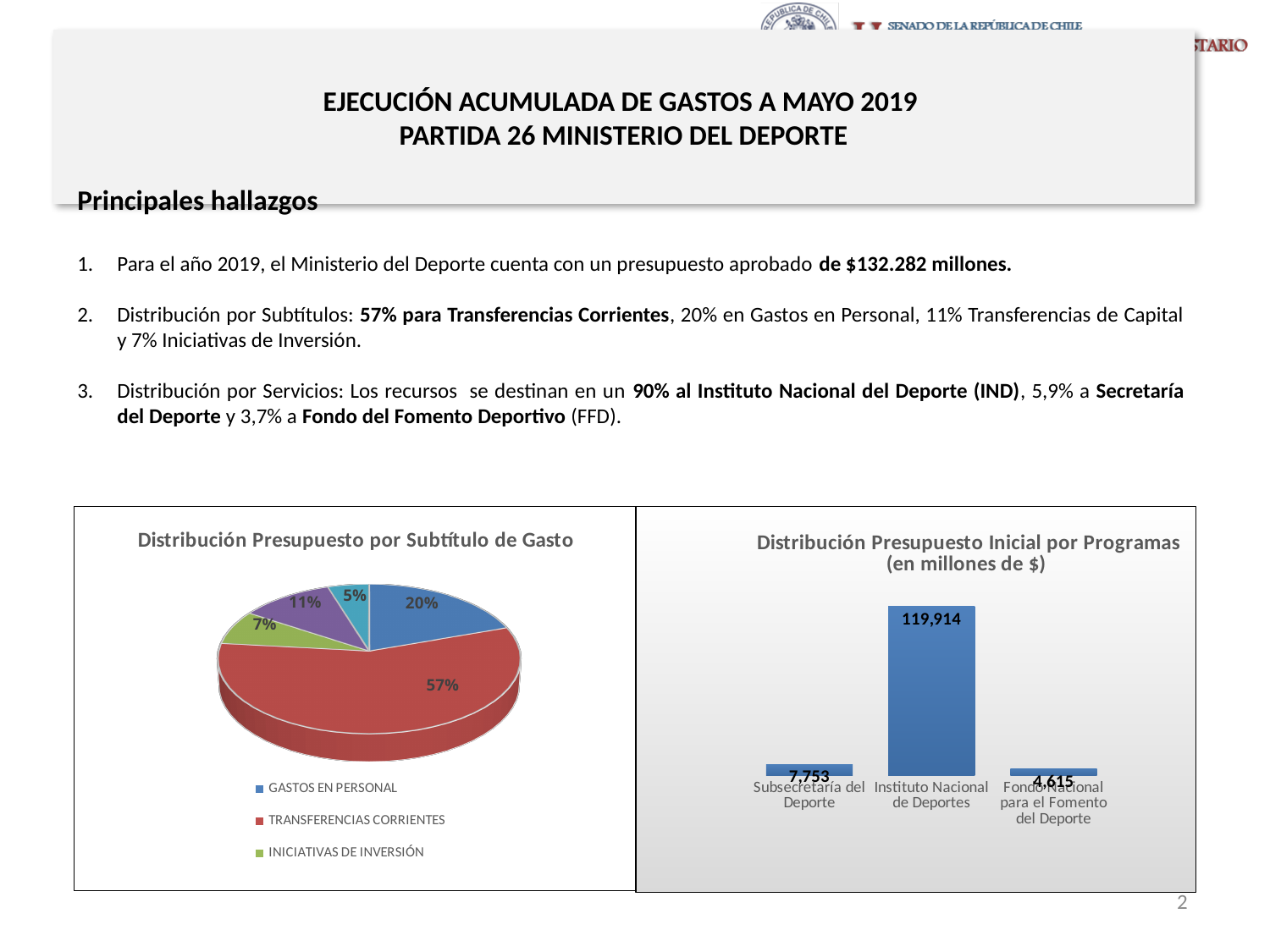
In the chart 'Distribución Presupuesto Inicial por Programas', which program has the lowest value? Fondo Nacional para el Fomento del Deporte What kind of chart is 'Distribución Presupuesto por Subtítulo de Gasto'? Pie chart In the pie chart 'Distribución Presupuesto por Subtítulo de Gasto', what share is shown for Iniciativas de Inversión? 7% In the chart 'Distribución Presupuesto Inicial por Programas', what is the difference between the values for Subsecretaría del Deporte and Fondo Nacional para el Fomento del Deporte? 3,138 How many entries does the legend of the pie chart 'Distribución Presupuesto por Subtítulo de Gasto' list? 3 In the pie chart 'Distribución Presupuesto por Subtítulo de Gasto', what share is shown for Transferencias Corrientes? 57% What kind of chart is 'Distribución Presupuesto Inicial por Programas'? Bar chart In the pie chart 'Distribución Presupuesto por Subtítulo de Gasto', which legend category has the largest slice? Transferencias Corrientes In the pie chart 'Distribución Presupuesto por Subtítulo de Gasto', what share is shown for Gastos en Personal? 20% In the chart 'Distribución Presupuesto Inicial por Programas', what is the value for Subsecretaría del Deporte? 7,753 In the chart 'Distribución Presupuesto Inicial por Programas', what is the value for Instituto Nacional de Deportes? 119,914 In the chart 'Distribución Presupuesto Inicial por Programas', what is the value for Fondo Nacional para el Fomento del Deporte? 4,615